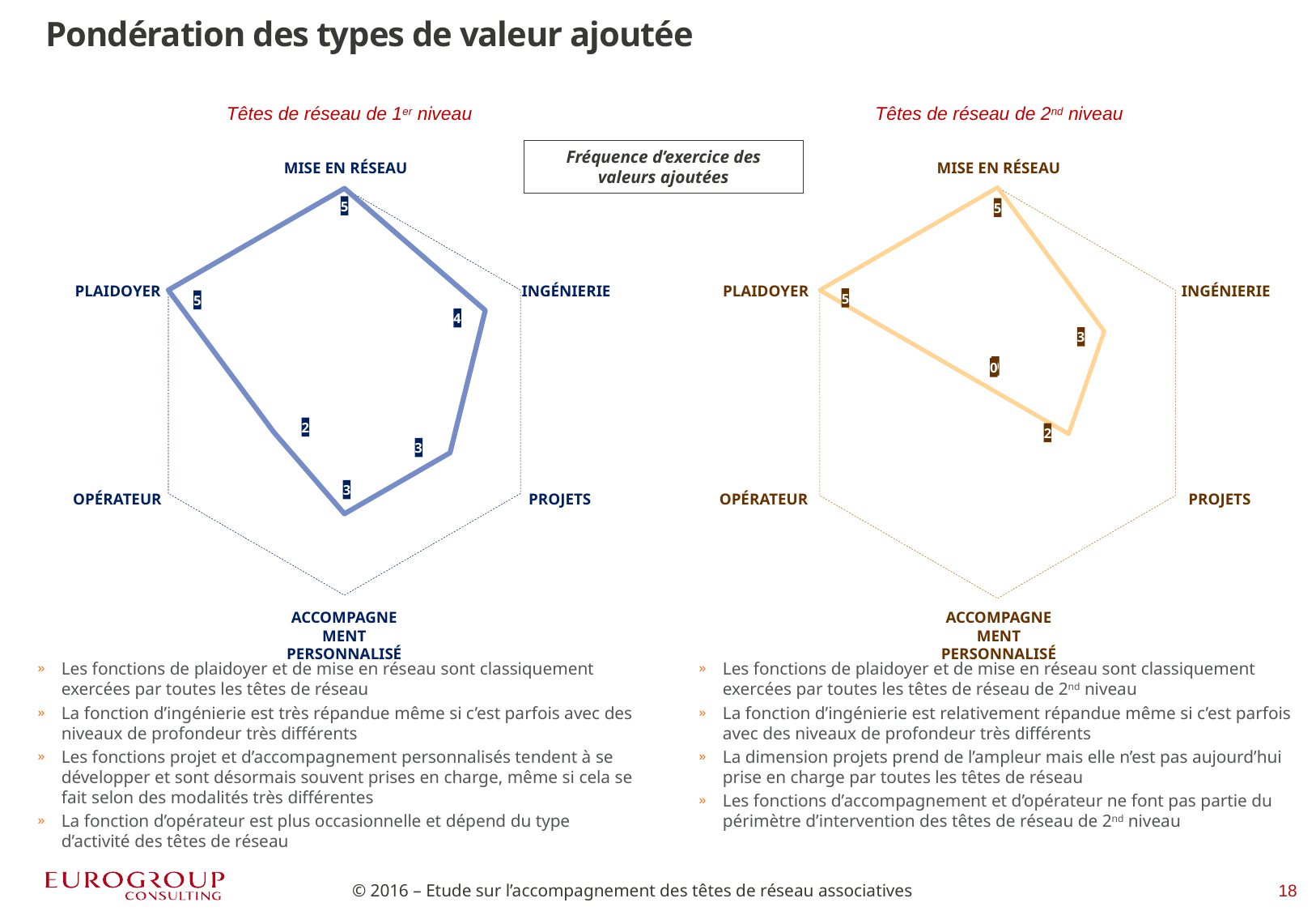
On the right chart (Têtes de réseau de 2nd niveau), what is the value for INGÉNIERIE? 3 On the left chart (Têtes de réseau de 1er niveau), what is the value for PROJETS? 3 On the right chart (Têtes de réseau de 2nd niveau), what is the value for PROJETS? 2 On the left chart (Têtes de réseau de 1er niveau), what is the value for OPÉRATEUR? 2 On the left chart (Têtes de réseau de 1er niveau), what is the value for INGÉNIERIE? 4 On the left chart (Têtes de réseau de 1er niveau), what is the difference between the values for INGÉNIERIE and OPÉRATEUR? 2 On the left chart (Têtes de réseau de 1er niveau), which category has the lowest value? OPÉRATEUR Which is larger: the value for INGÉNIERIE on the left chart or the value for INGÉNIERIE on the right chart? Left chart (4) How many categories (axes) does the left chart (Têtes de réseau de 1er niveau) have? 6 On the left chart (Têtes de réseau de 1er niveau), what is the value for MISE EN RÉSEAU? 5 What kind of chart is used on this slide? Radar chart On the right chart (Têtes de réseau de 2nd niveau), what is the value for PLAIDOYER? 5